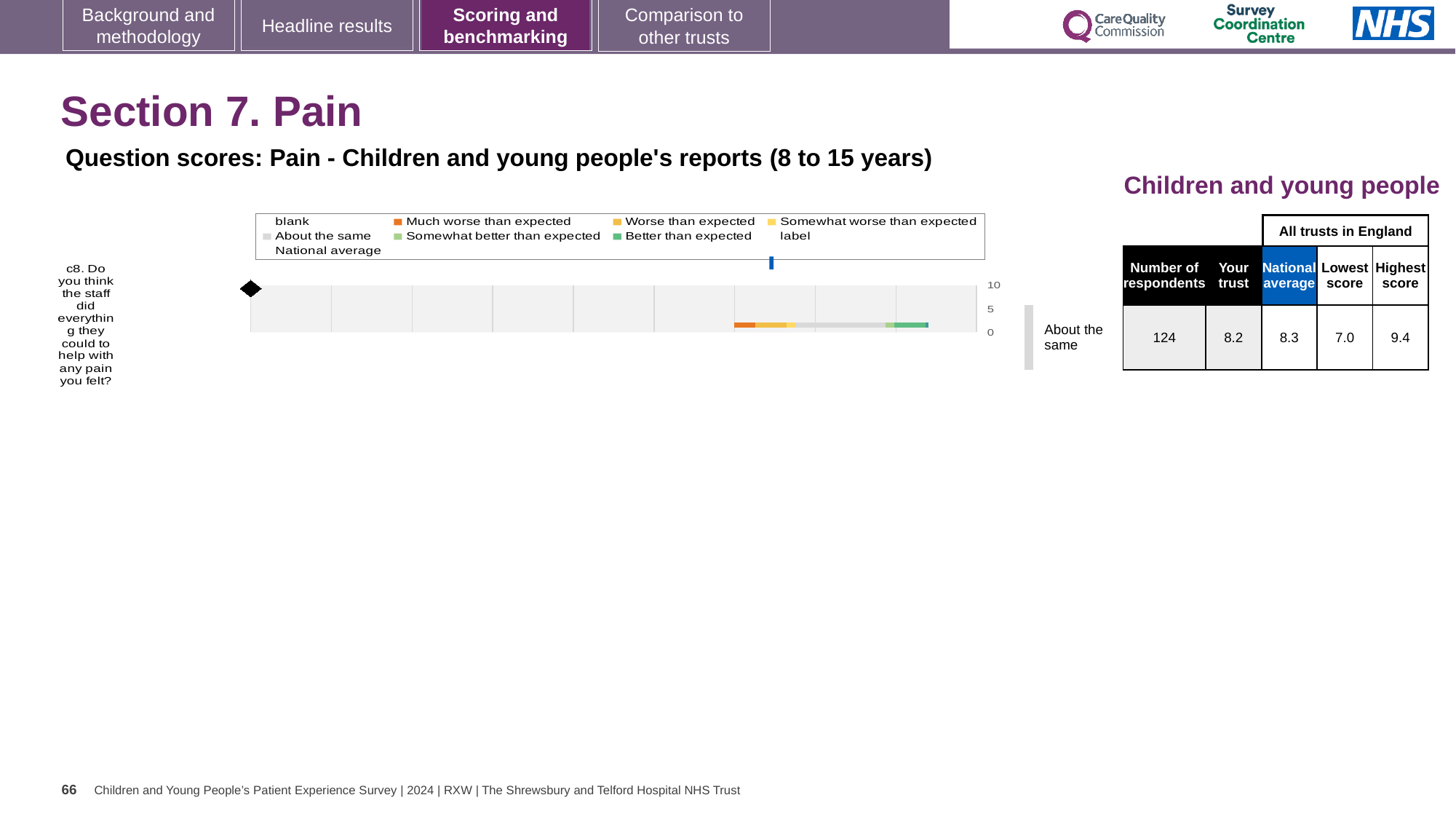
What is the lowest score among all trusts in England for question c8? 7.0 What is the highest score among all trusts in England for question c8? 9.4 What is the number of respondents for question c8? 124 Is the trust's score marker for question c8 greater or less than 5 on the chart axis? greater What kind of chart is used to show the c8 question score? bar chart Which is larger for question c8: the 'Your trust' score or the national average? National average What is the 'Your trust' score for question c8? 8.2 What is the national average score for question c8? 8.3 What is the difference between the highest score and the lowest score for question c8? 2.4 How many survey questions are plotted in the chart? 1 Which benchmark category is the trust's c8 score placed in? About the same What is the highest value shown on the chart's score axis? 10